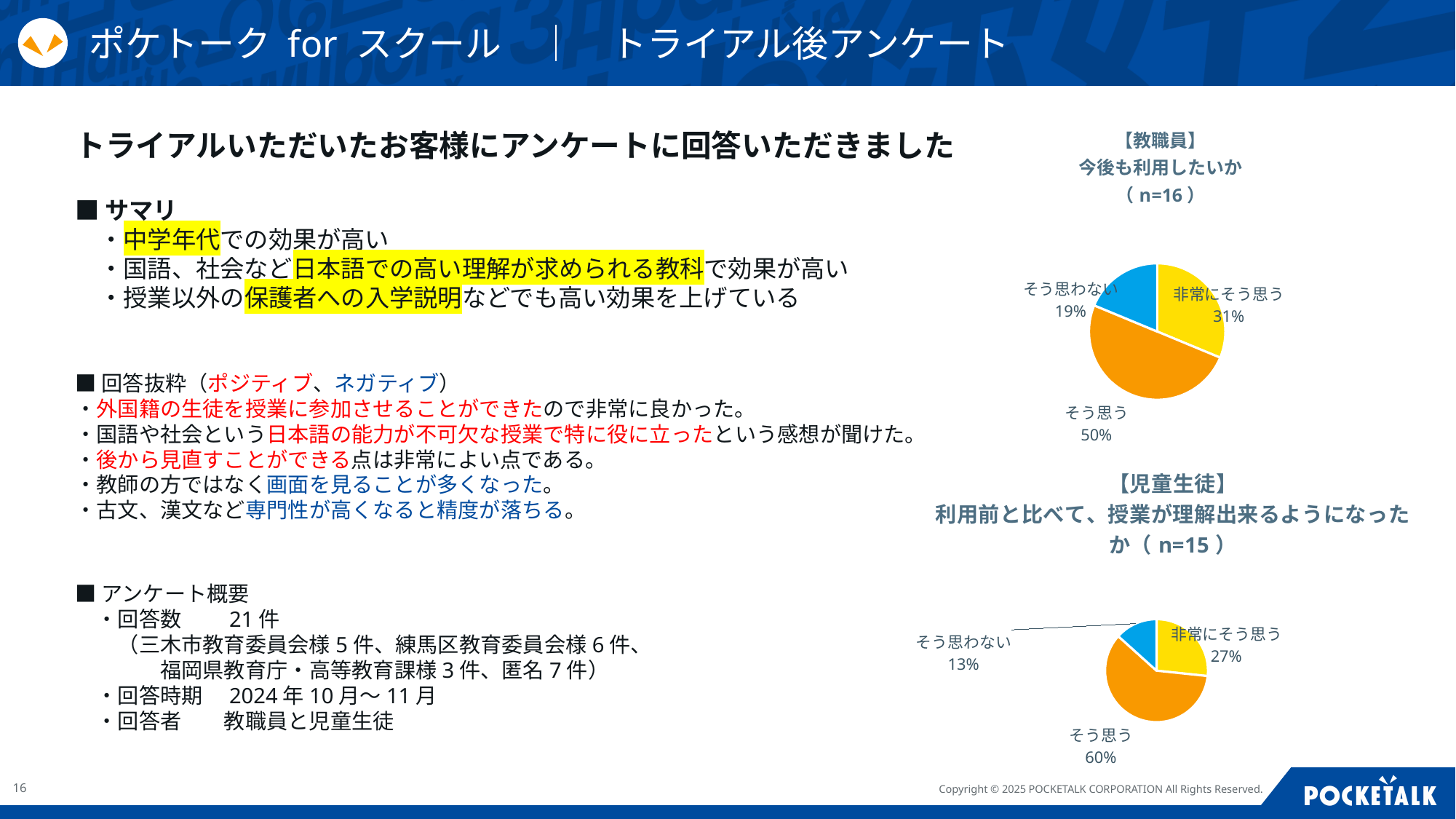
In the bottom chart (【児童生徒】), how many response categories are shown? 3 In the top chart (【教職員】今後も利用したいか), what percentage answered 非常にそう思う? 31% In the top chart (【教職員】今後も利用したいか), what percentage answered そう思わない? 19% What is the sample size (n) shown in the title of the bottom chart (【児童生徒】)? n=15 In the top chart (【教職員】今後も利用したいか), which response has the largest share? そう思う In the bottom chart (【児童生徒】), which is larger: 非常にそう思う or そう思わない? 非常にそう思う In the top chart (【教職員】今後も利用したいか), what percentage of respondents answered そう思う? 50% In the bottom chart (【児童生徒】), what percentage answered そう思う? 60% In the bottom chart (【児童生徒】), what percentage answered そう思わない? 13% In the top chart (【教職員】今後も利用したいか), what is the difference in percentage points between そう思う and 非常にそう思う? 19 percentage points In the top chart (【教職員】今後も利用したいか), which response has the smallest share? そう思わない What type of chart is used for the 【教職員】今後も利用したいか data? Pie chart